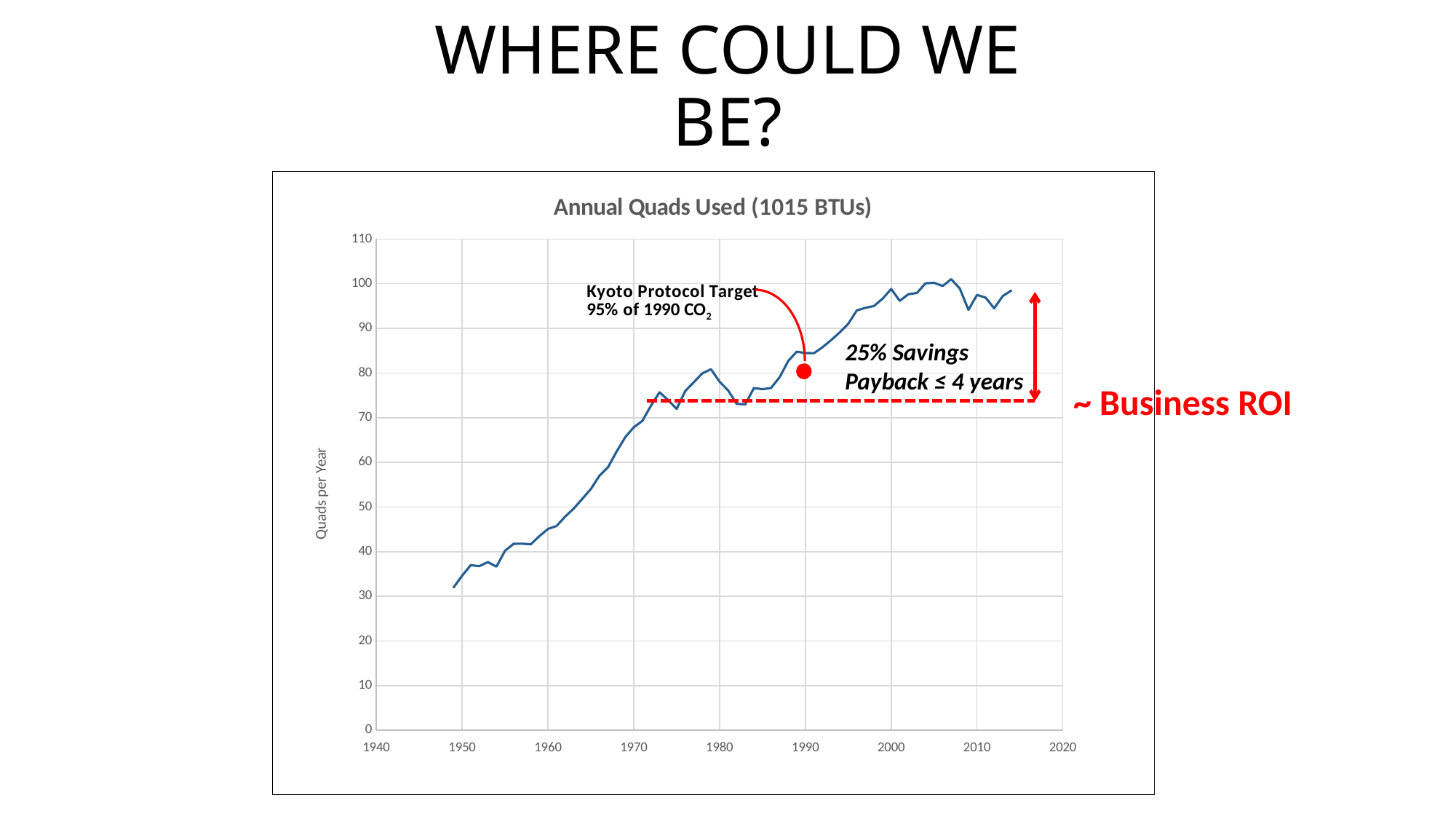
Is the value for 2010 greater or less than 90? greater Is the value for 1980 greater or less than 70? greater Is the value for 2000 greater or less than 90? greater What is the label on the vertical axis of the chart? Quads per Year Which year has the larger value, 1960 or 2000? 2000 What kind of chart is shown on the slide? line chart Overall, do the values on the chart rise or fall from 1950 to 2010? rise What is the title of the chart? Annual Quads Used (1015 BTUs)